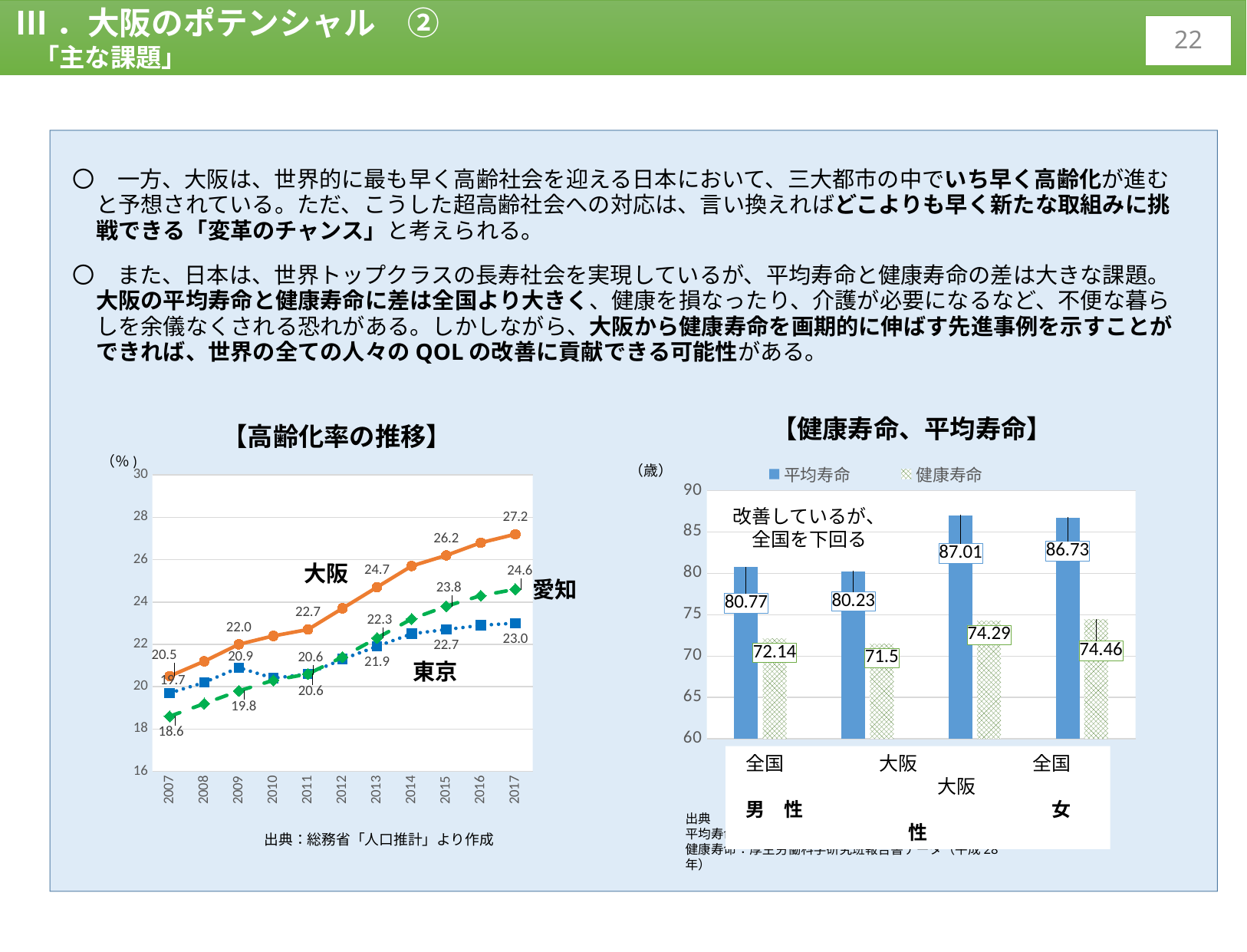
In the 【高齢化率の推移】 chart, what is the value for 愛知 in 2007? 18.6 In the 【高齢化率の推移】 chart, what is the difference between 大阪 and 東京 in 2017? 4.2 In the 【健康寿命、平均寿命】 chart, what is the 平均寿命 for 大阪 men (男性)? 80.23 How many series does the legend of the 【健康寿命、平均寿命】 chart list? 2 In the 【高齢化率の推移】 chart, what is the value for 大阪 in 2017? 27.2 In the 【健康寿命、平均寿命】 chart, what is the 健康寿命 for 全国 women (女性)? 74.46 In the 【高齢化率の推移】 chart, does the value for 大阪 rise or fall from 2007 to 2017? rise What kind of chart is the 【高齢化率の推移】 chart? line chart In the 【高齢化率の推移】 chart, how many years are shown on the x axis? 11 In the 【高齢化率の推移】 chart, what is the value for 東京 in 2015? 22.7 In the 【高齢化率の推移】 chart, which series has the highest value in 2017? 大阪 In the 【健康寿命、平均寿命】 chart, what is the difference between 平均寿命 and 健康寿命 for 大阪 women (女性)? 12.72